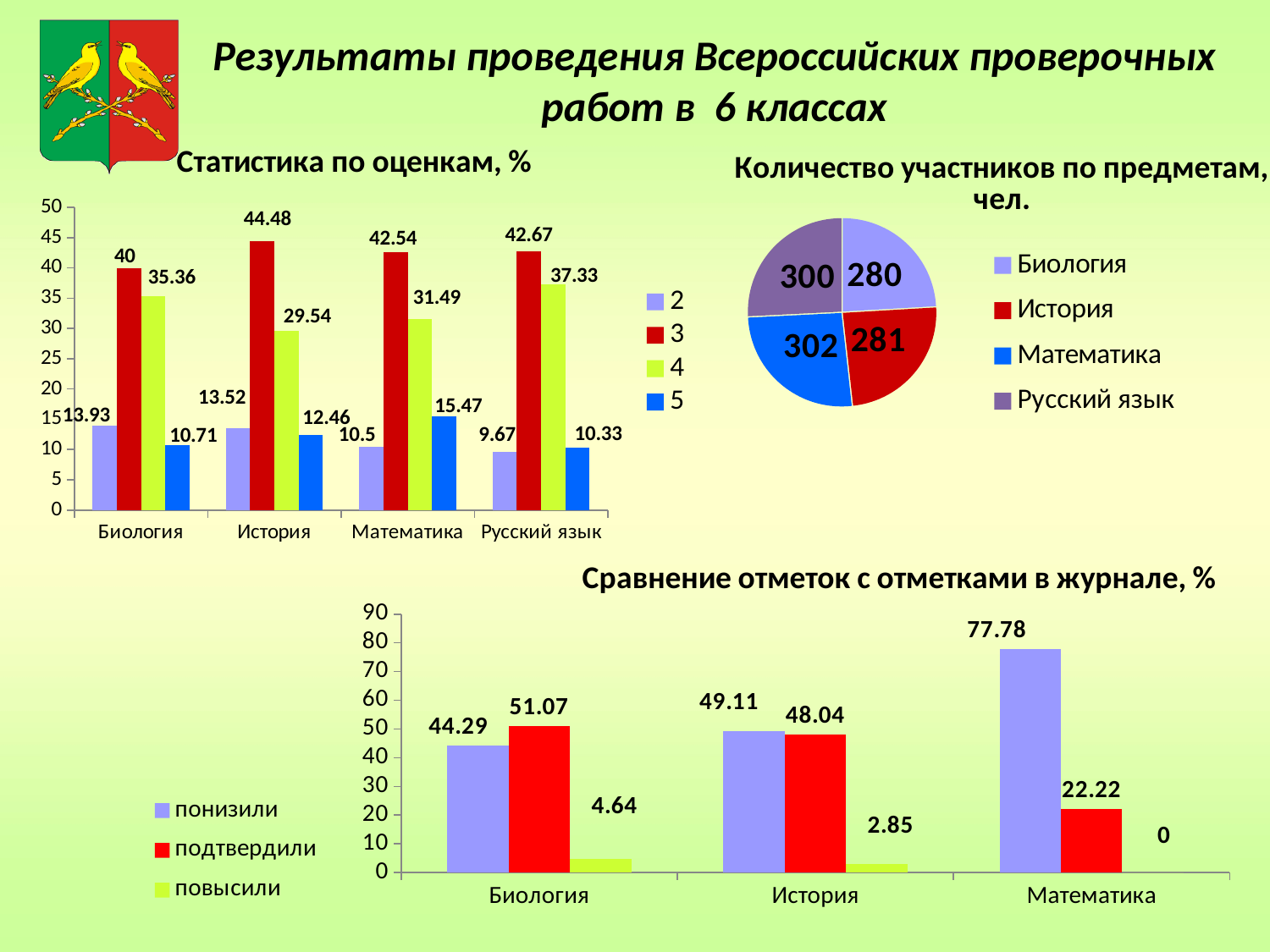
In the chart 'Статистика по оценкам, %', what is the value for grade 3 in История? 44.48 In the chart 'Статистика по оценкам, %', which subject has the lowest value for grade 2? Русский язык In the chart 'Статистика по оценкам, %', what is the value for grade 5 in Математика? 15.47 In the pie chart 'Количество участников по предметам, чел.', which subject has the fewest participants? Биология What kind of chart is 'Сравнение отметок с отметками в журнале, %'? bar chart In the pie chart 'Количество участников по предметам, чел.', what is the total number of participants across all four subjects? 1163 In the chart 'Сравнение отметок с отметками в журнале, %', which is larger for История: 'понизили' or 'подтвердили'? понизили In the chart 'Сравнение отметок с отметками в журнале, %', what is the difference between 'подтвердили' and 'понизили' for Биология? 6.78 In the chart 'Сравнение отметок с отметками в журнале, %', what is the value for 'понизили' in Математика? 77.78 In the chart 'Статистика по оценкам, %', how many series does the legend list? 4 In the chart 'Статистика по оценкам, %', what is the difference between the grade 4 values for Русский язык and Биология? 1.97 In the pie chart 'Количество участников по предметам, чел.', how many participants are shown for Математика? 302